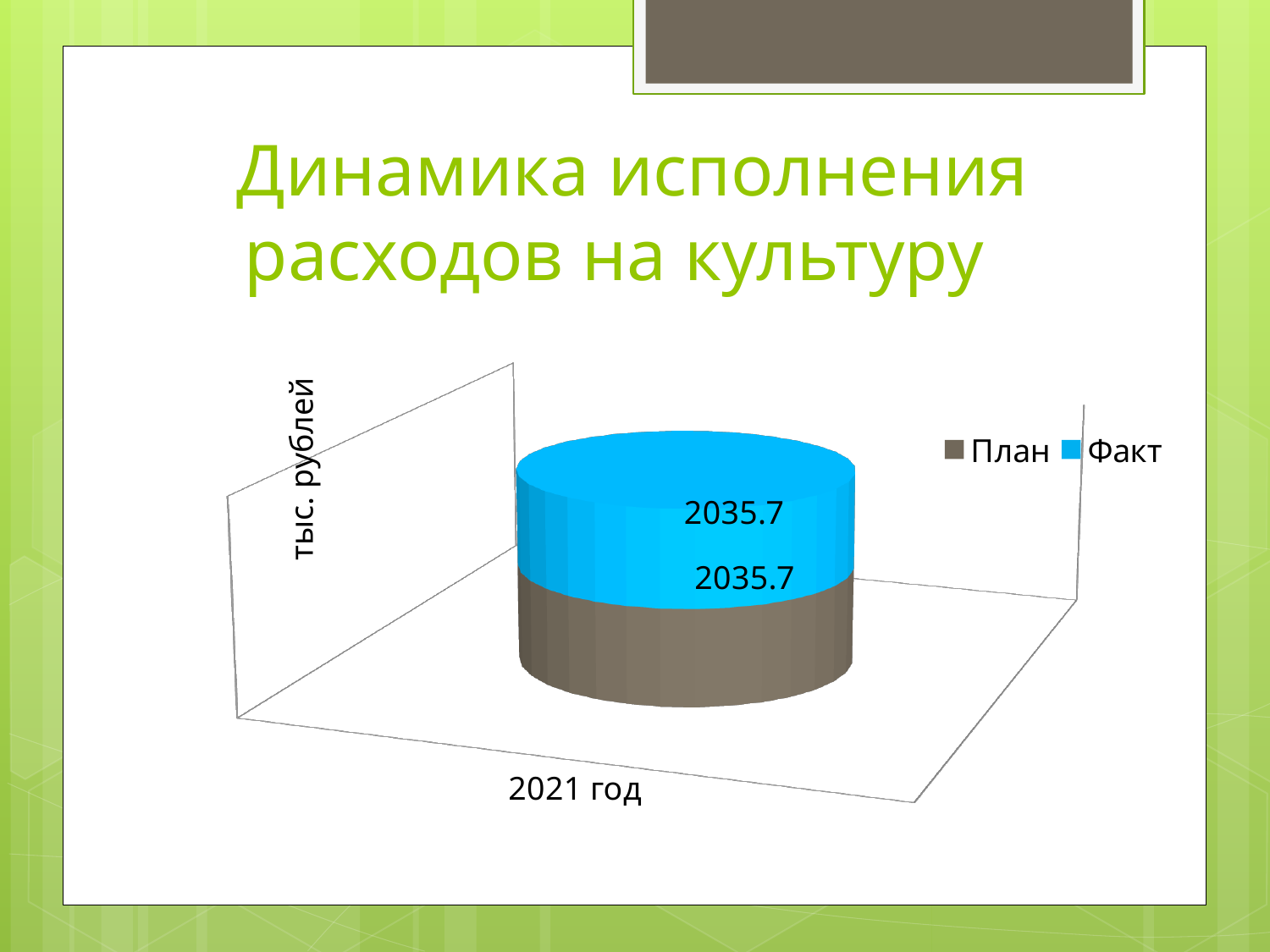
How many categories are shown on the x axis of the chart? 1 What is the value for Факт in 2021 год? 2035.7 What is the total of the stacked bar for 2021 год? 4071.4 Is the value for План larger than, smaller than, or equal to the value for Факт in 2021 год? equal What is the label on the vertical axis of the chart? тыс. рублей Which category label appears on the x axis? 2021 год What is the difference between the План and Факт values for 2021 год? 0 How many series does the legend list? 2 What is the title of the slide containing the chart? Динамика исполнения расходов на культуру What kind of chart is shown on the slide? Stacked bar chart What is the value for План in 2021 год? 2035.7